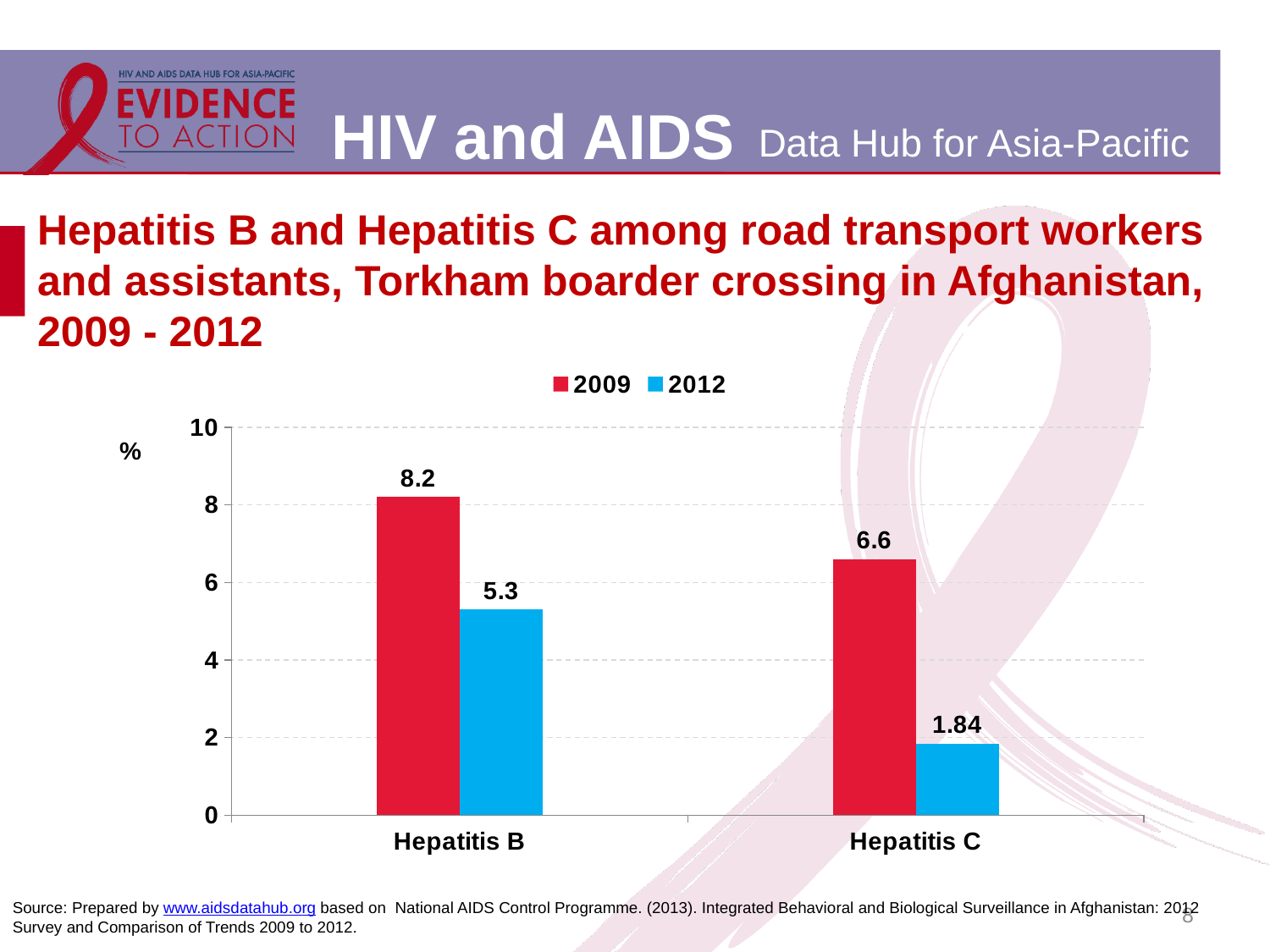
What kind of chart is shown on the slide? Bar chart What is the value for Hepatitis B in 2012? 5.3 What is the difference between the 2009 and 2012 values for Hepatitis C? 4.76 How many categories are shown on the x axis? 2 What is the value for Hepatitis C in 2012? 1.84 Which colour represents the 2012 series in the legend? Blue What is the difference between the 2009 and 2012 values for Hepatitis B? 2.9 Which category has the lowest 2012 value? Hepatitis C Which category has the highest 2009 value? Hepatitis B How many series does the legend list? 2 What is the value for Hepatitis B in 2009? 8.2 Which is larger: the 2012 value for Hepatitis B or the 2009 value for Hepatitis C? 2009 value for Hepatitis C